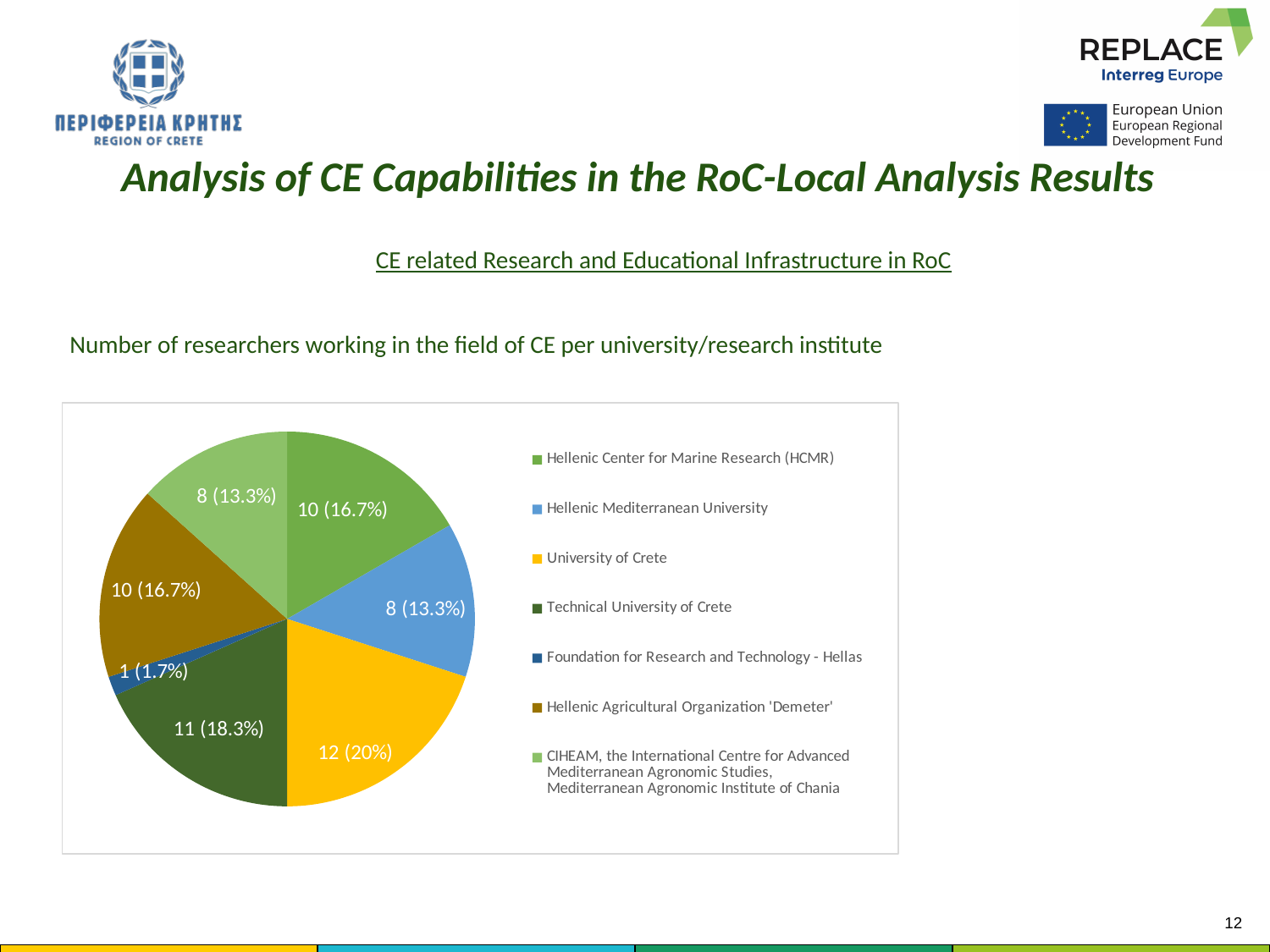
Which institution has the smallest slice of the pie? Foundation for Research and Technology - Hellas What share of the pie does the Hellenic Mediterranean University represent? 13.3% What value is shown for the Technical University of Crete? 11 (18.3%) How many institutions are listed in the legend of the pie chart? 7 Which institution has the largest slice of the pie? University of Crete What value is shown for the Hellenic Center for Marine Research (HCMR)? 10 (16.7%) What value is shown for the Foundation for Research and Technology - Hellas? 1 (1.7%) What is the difference in number of researchers between the University of Crete and the Technical University of Crete? 1 Which has more researchers, the Hellenic Mediterranean University or the Hellenic Agricultural Organization 'Demeter'? Hellenic Agricultural Organization 'Demeter' What type of chart is shown on the slide? pie chart What is the total number of researchers across all slices of the pie chart? 60 How many researchers does the University of Crete have according to the pie chart? 12 (20%)